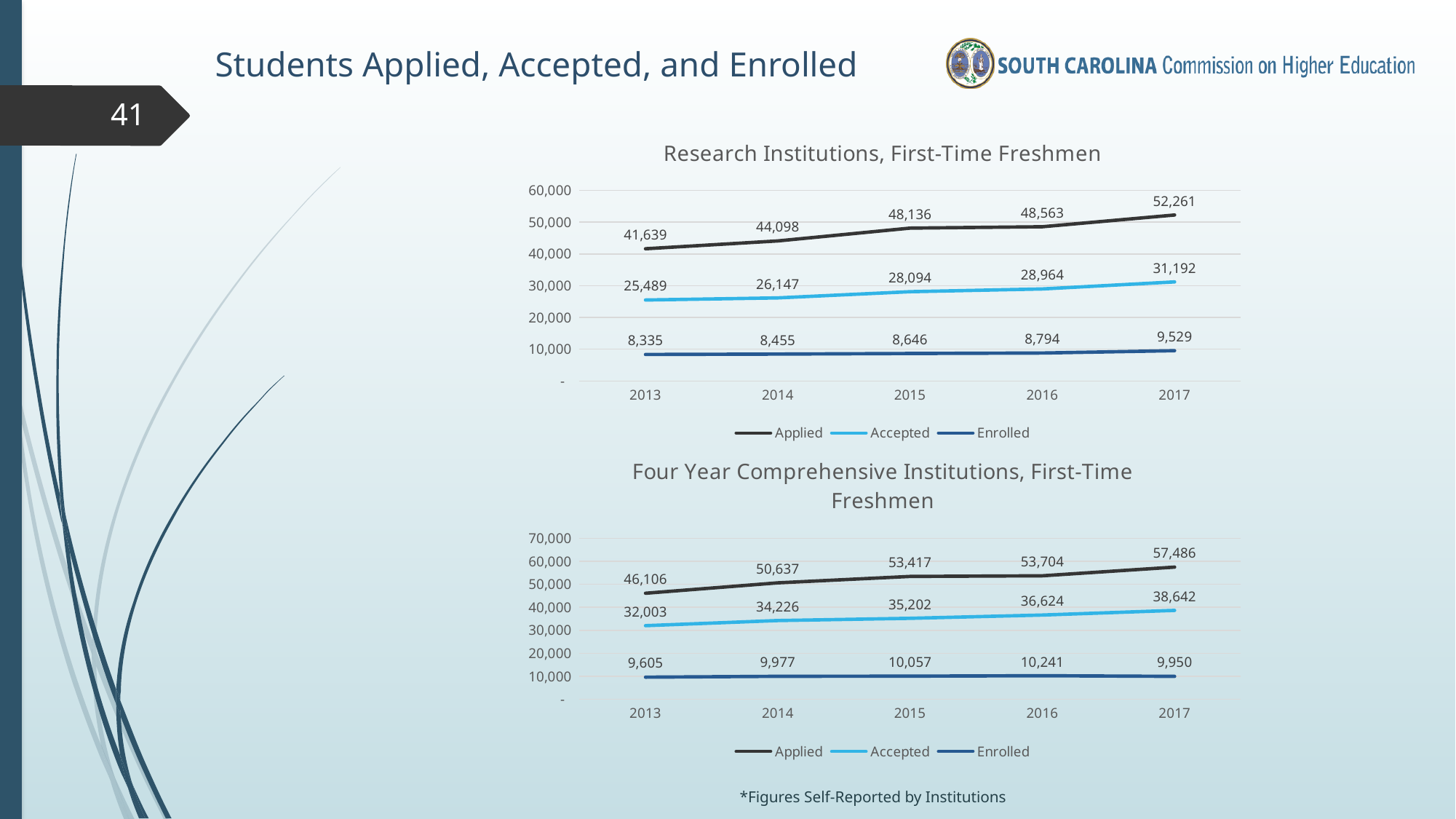
In the 'Research Institutions, First-Time Freshmen' chart, which year has the lowest Accepted value? 2013 In the 'Research Institutions, First-Time Freshmen' chart, what is the Enrolled value for 2015? 8,646 In the 'Four Year Comprehensive Institutions, First-Time Freshmen' chart, what is the Accepted value for 2016? 36,624 In the 'Four Year Comprehensive Institutions, First-Time Freshmen' chart, is the Enrolled value for 2017 larger or smaller than the Enrolled value for 2016? smaller In the 'Research Institutions, First-Time Freshmen' chart, does the Applied series rise or fall from 2013 to 2017? rise In the 'Research Institutions, First-Time Freshmen' chart, how many years are shown on the x axis? 5 In the 'Research Institutions, First-Time Freshmen' chart, what is the difference between the Applied and Accepted values in 2013? 16,150 In the 'Research Institutions, First-Time Freshmen' chart, what is the Applied value for 2017? 52,261 In the 'Four Year Comprehensive Institutions, First-Time Freshmen' chart, what is the difference between the Applied values for 2017 and 2013? 11,380 What type of chart is the 'Research Institutions, First-Time Freshmen' chart? Line chart In the 'Four Year Comprehensive Institutions, First-Time Freshmen' chart, which year has the highest Enrolled value? 2016 How many series does the legend of the 'Four Year Comprehensive Institutions, First-Time Freshmen' chart list? 3